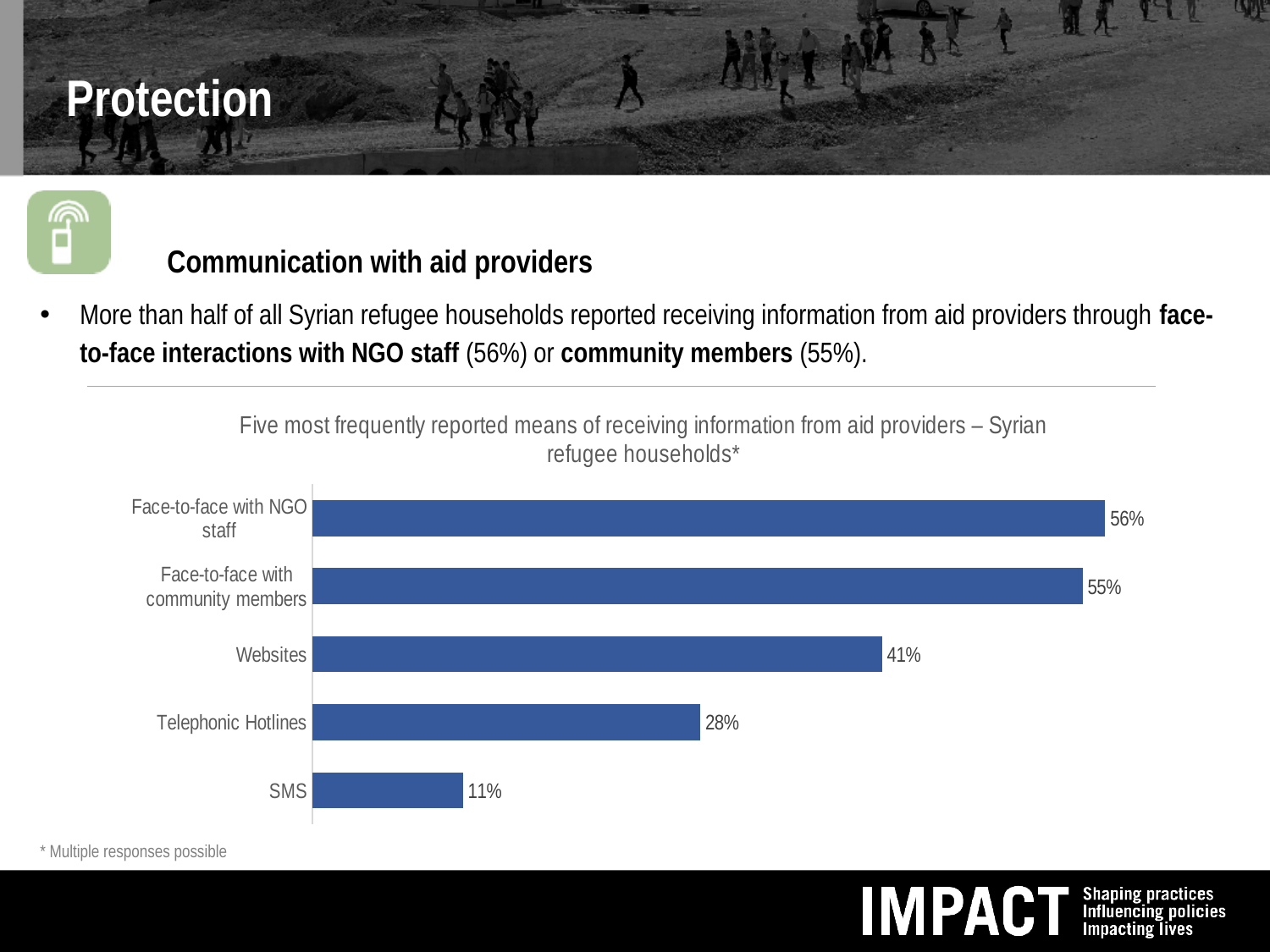
What does the asterisk note below the chart say? Multiple responses possible What percentage of Syrian refugee households reported receiving information through websites? 41% Which is larger, the value for Websites or the value for Telephonic Hotlines? Websites What is the difference between the percentages for Face-to-face with NGO staff and SMS? 45% How many means of receiving information are shown in the chart? 5 What is the title of the chart? Five most frequently reported means of receiving information from aid providers – Syrian refugee households* Which means of receiving information has the lowest reported percentage? SMS Which means of receiving information has the highest reported percentage? Face-to-face with NGO staff What is the value shown for SMS? 11% What is the difference between the percentages for Websites and Telephonic Hotlines? 13% What kind of chart is shown on the slide? Bar chart What is the value shown for Telephonic Hotlines? 28%